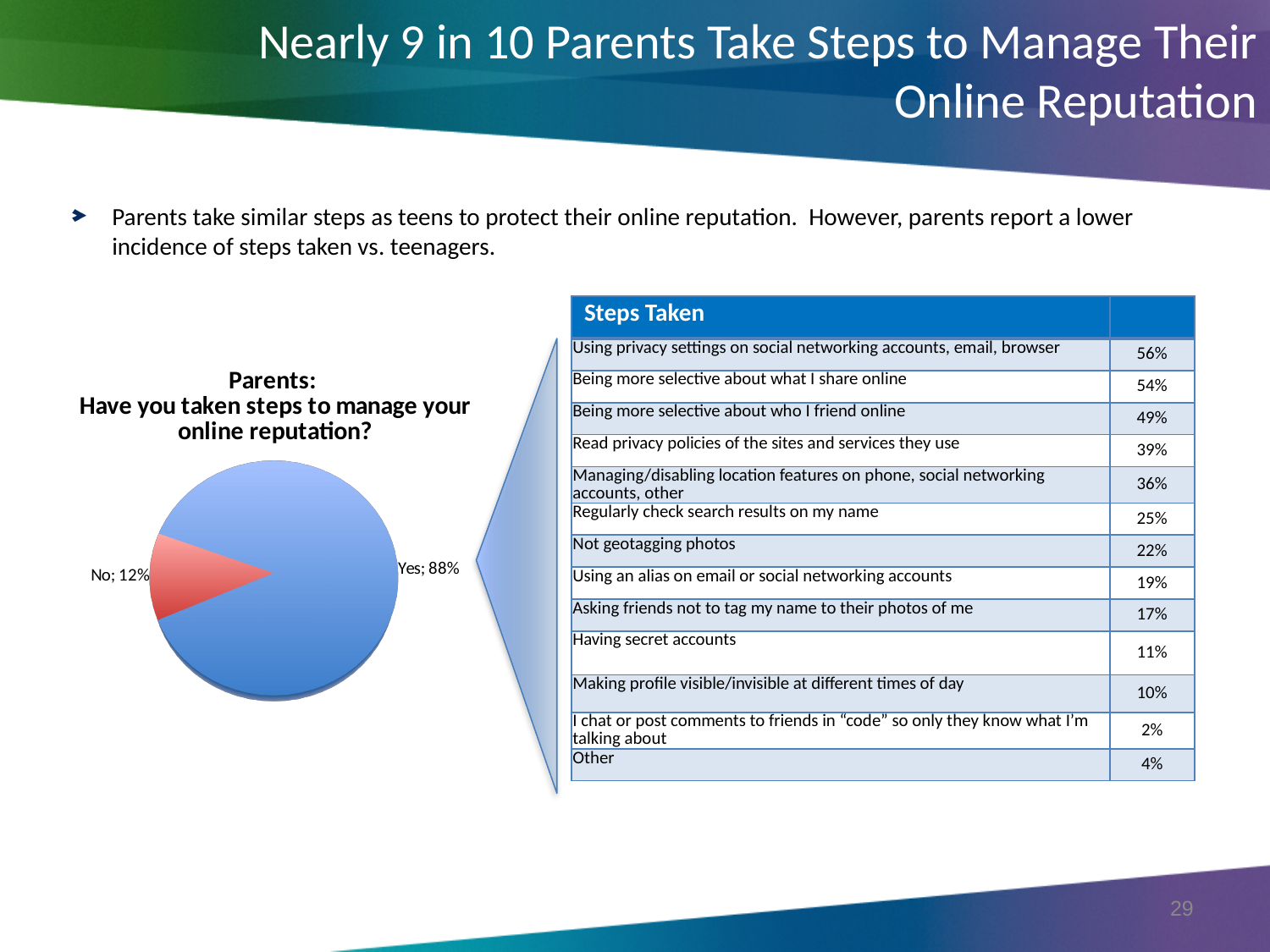
Which slice of the pie chart is the smallest? No What is the difference between the Yes and No shares in the pie chart? 76% What kind of chart is shown on the slide? pie chart What is the title of the pie chart? Parents: Have you taken steps to manage your online reputation? Which is larger in the pie chart, the Yes slice or the No slice? Yes What colour is the No slice in the pie chart? red Which slice of the pie chart is the largest? Yes What share of the pie chart is labelled Yes? 88% How many slices does the pie chart have? 2 What share of the pie chart is labelled No? 12%